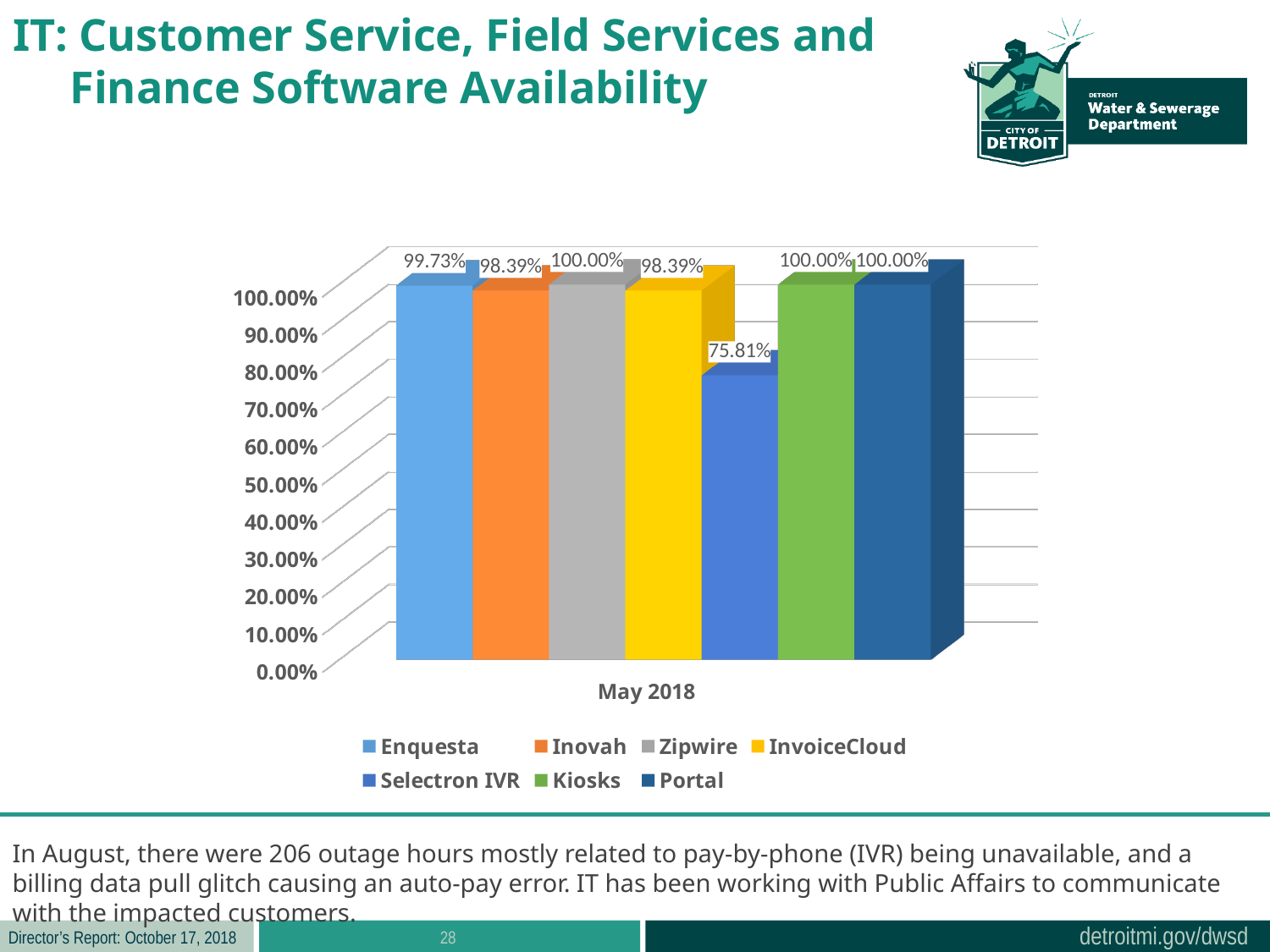
Which has the larger value, Enquesta or Inovah? Enquesta What is the difference between the Enquesta value and the Selectron IVR value? 23.92% Is the value for Selectron IVR greater or less than 80.00%? less What is the availability value for Kiosks? 100.00% What is the label of the category on the x axis? May 2018 What is the availability value for Inovah? 98.39% What kind of chart is shown on the slide? bar chart What is the availability value for Enquesta? 99.73% What is the availability value for Selectron IVR? 75.81% How many categories are shown on the x axis? 1 How many series does the legend list? 7 Which series has the lowest availability value? Selectron IVR